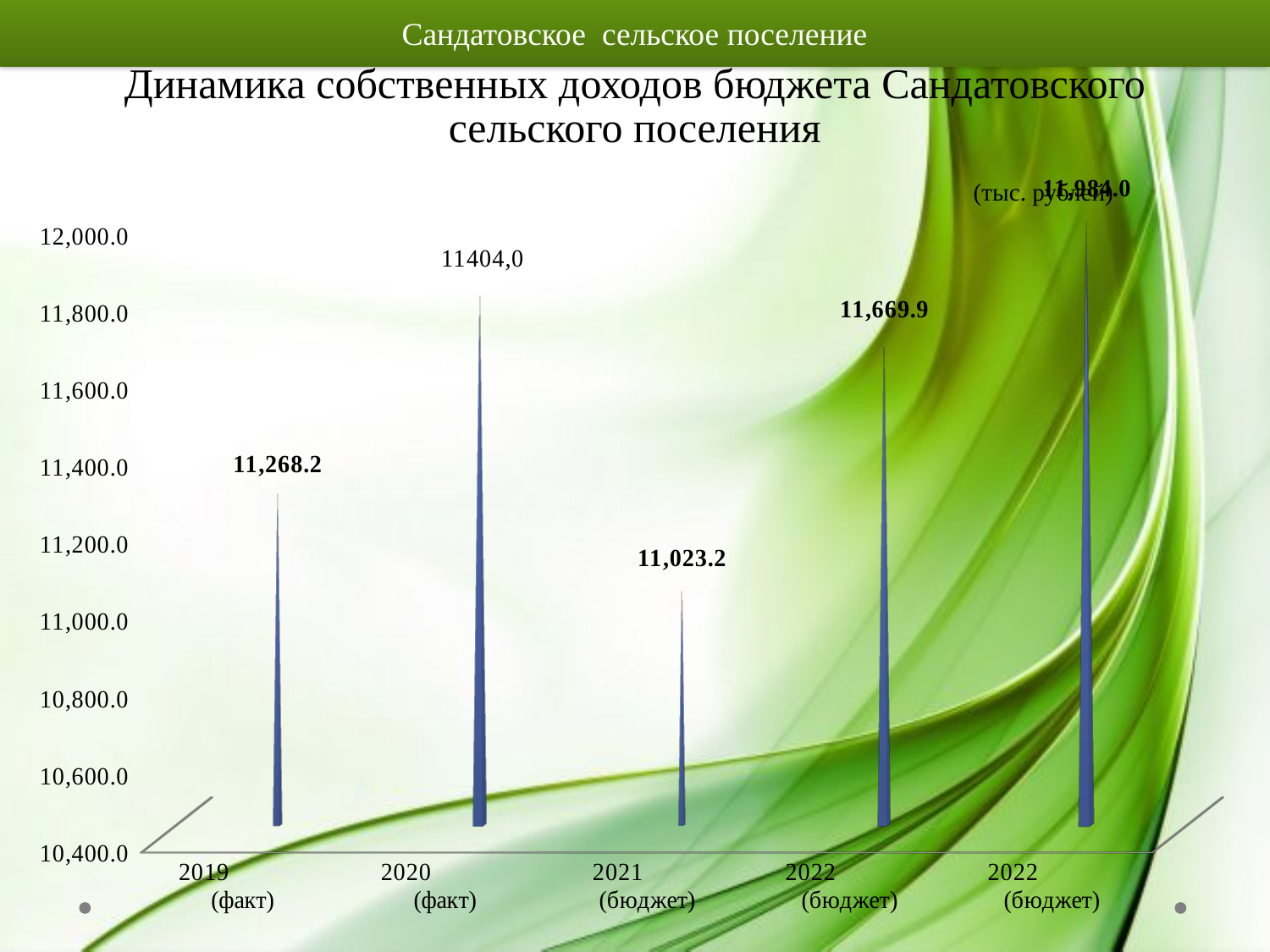
What is the value for 2019 (факт)? 11,268.2 How many bars are plotted on the chart? 5 In what units are the values on the chart given? тыс. рублей What is the value shown on the fourth bar from the left? 11,669.9 Which category has the lowest value? 2021 (бюджет) What is the difference between the values for 2019 (факт) and 2021 (бюджет)? 245.0 Is the value for 2021 (бюджет) greater or less than 11,200.0? less What is the value for 2020 (факт)? 11404,0 What is the value for 2021 (бюджет)? 11,023.2 Which is larger, the value for 2019 (факт) or for 2020 (факт)? 2020 (факт) Which bar has the highest value? The fifth (rightmost) bar What kind of chart is shown on the slide? Bar chart